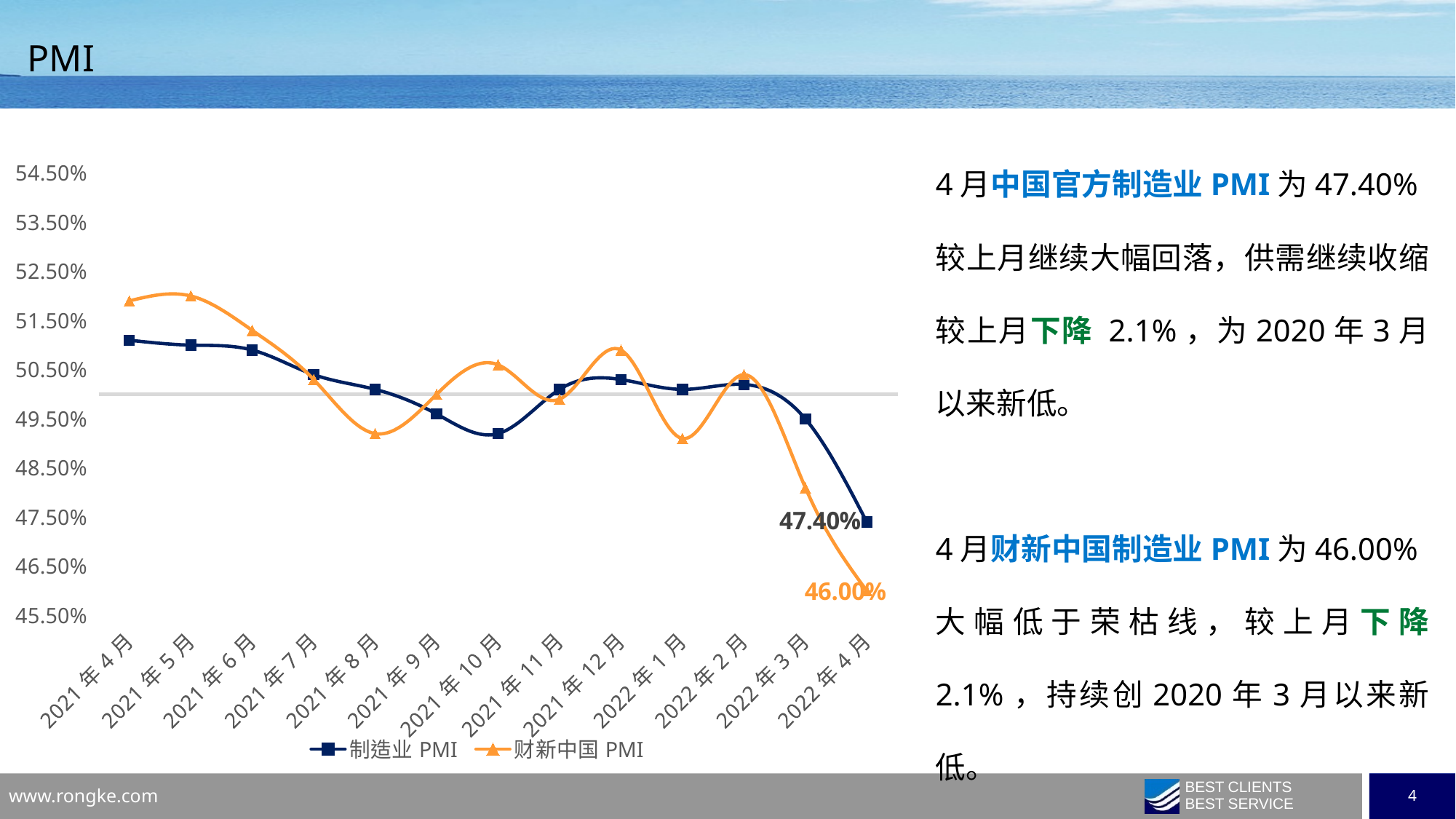
In which month is 财新中国 PMI at its lowest? 2022年4月 What is the value of 制造业 PMI for 2022年4月? 47.40% What is the difference between 制造业 PMI and 财新中国 PMI in 2022年4月? 1.40% How many series does the legend list? 2 What kind of chart is shown on the slide? Line chart How many months are plotted along the x axis? 13 Is the value of 财新中国 PMI for 2022年3月 greater or less than 48.50%? less What is the value of 财新中国 PMI for 2022年4月? 46.00% Is the value of 财新中国 PMI for 2021年5月 greater or less than 51.50%? greater From 2022年2月 to 2022年4月, does 制造业 PMI rise or fall? fall Is the value of 制造业 PMI for 2021年10月 greater or less than 49.50%? less In 2022年4月, which series has the higher value, 制造业 PMI or 财新中国 PMI? 制造业 PMI